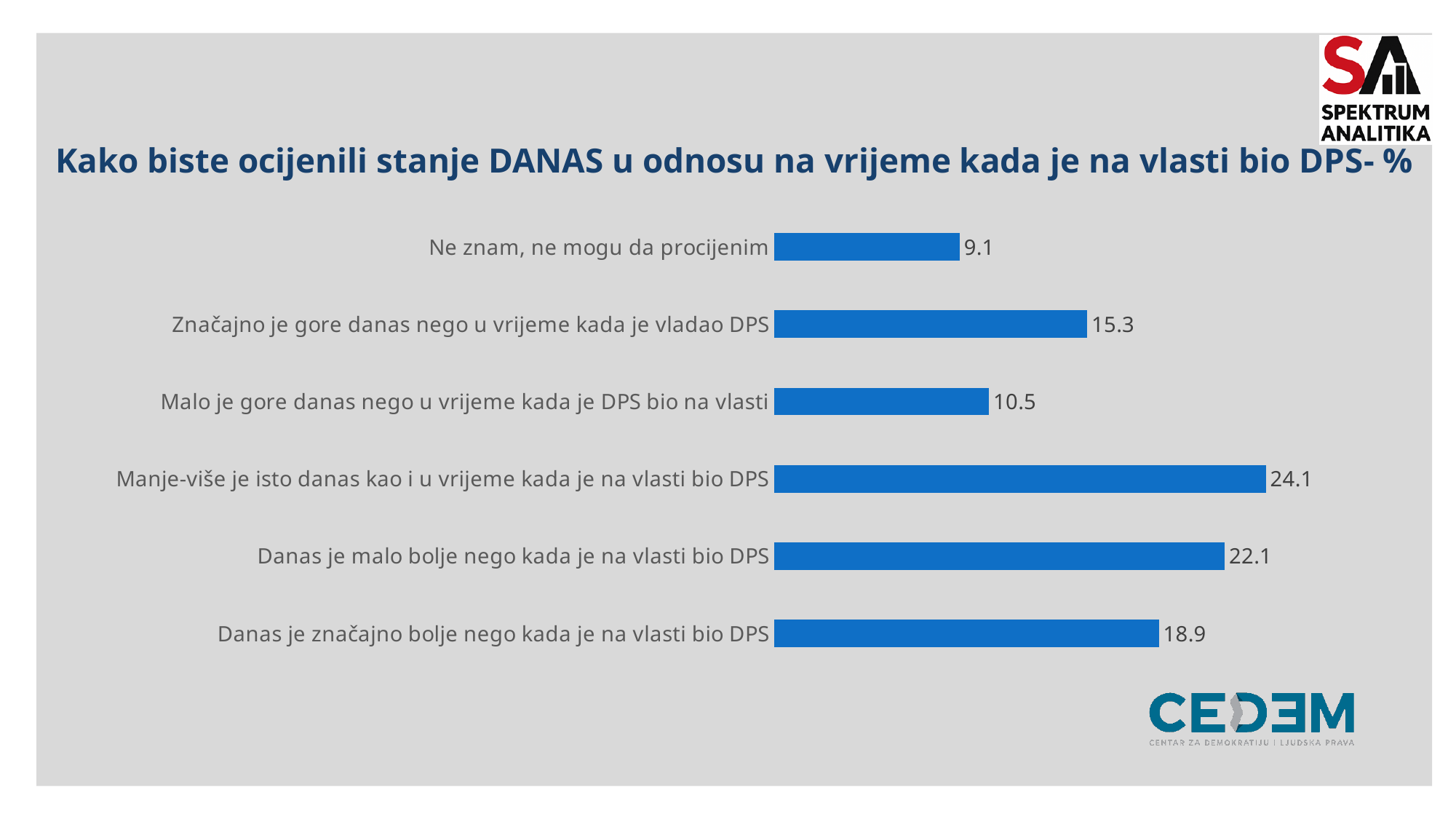
Which is larger: the value for "Značajno je gore danas nego u vrijeme kada je vladao DPS" or the value for "Ne znam, ne mogu da procijenim"? Značajno je gore danas nego u vrijeme kada je vladao DPS What value is shown for "Ne znam, ne mogu da procijenim"? 9.1 How many categories are shown in the chart? 6 What is the difference between the values for "Danas je malo bolje nego kada je na vlasti bio DPS" and "Danas je značajno bolje nego kada je na vlasti bio DPS"? 3.2 What value is shown for "Manje-više je isto danas kao i u vrijeme kada je na vlasti bio DPS"? 24.1 Which category has the highest value? Manje-više je isto danas kao i u vrijeme kada je na vlasti bio DPS What value is shown for "Malo je gore danas nego u vrijeme kada je DPS bio na vlasti"? 10.5 Which category has the lowest value? Ne znam, ne mogu da procijenim What kind of chart is shown on the slide? Bar chart What value is shown for "Danas je značajno bolje nego kada je na vlasti bio DPS"? 18.9 What is the difference between the values for "Značajno je gore danas nego u vrijeme kada je vladao DPS" and "Malo je gore danas nego u vrijeme kada je DPS bio na vlasti"? 4.8 What is the title of the chart? Kako biste ocijenili stanje DANAS u odnosu na vrijeme kada je na vlasti bio DPS- %